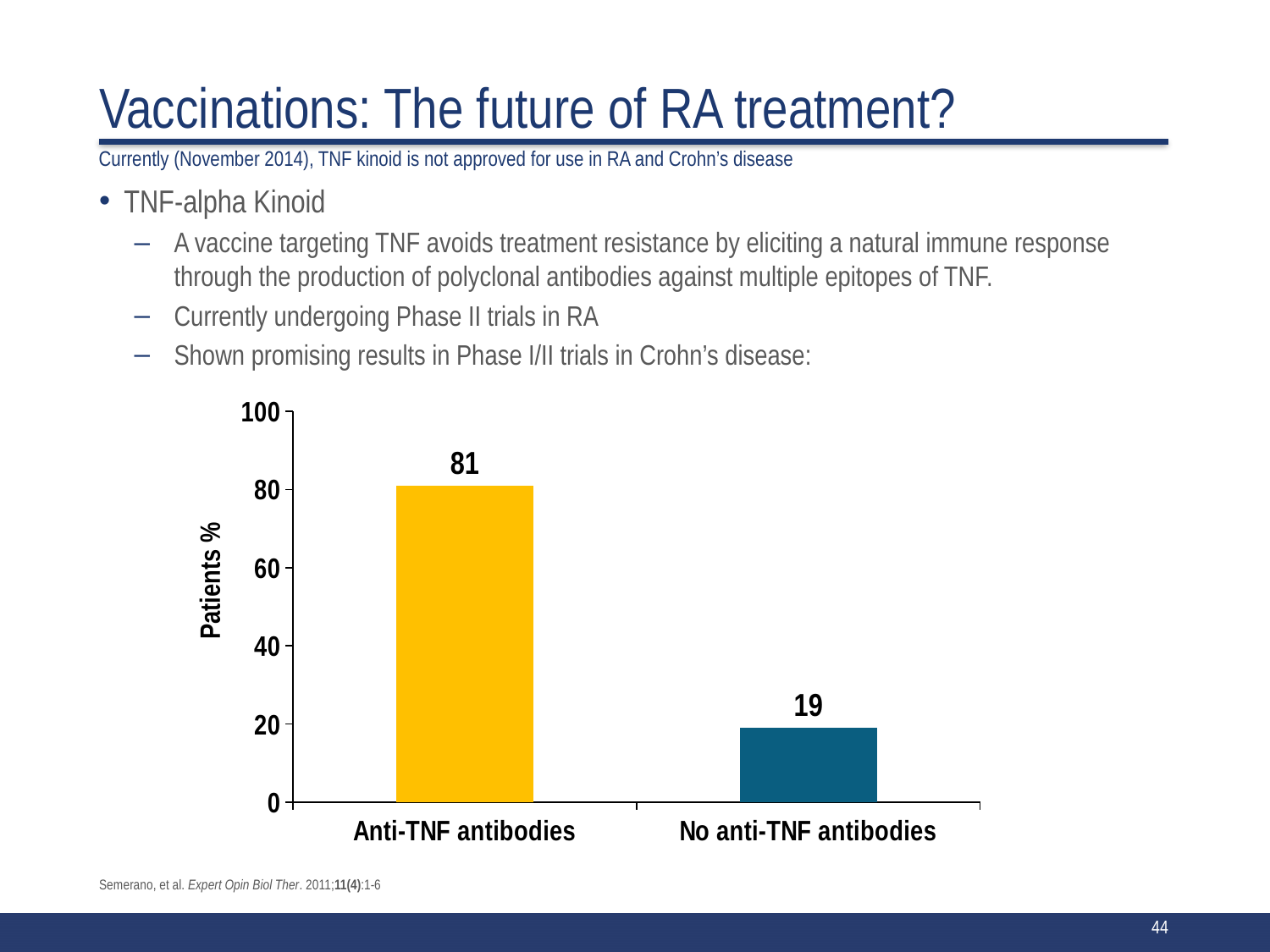
What is the label of the y axis? Patients % Is the value for Anti-TNF antibodies greater or less than 80? greater Which is larger, the value for Anti-TNF antibodies or for No anti-TNF antibodies? Anti-TNF antibodies What is the difference between the values for Anti-TNF antibodies and No anti-TNF antibodies? 62 Which category has the highest value? Anti-TNF antibodies What is the value for Anti-TNF antibodies? 81 What kind of chart is shown on the slide? bar chart How many categories are shown on the x axis? 2 Which category has the lowest value? No anti-TNF antibodies What is the value for No anti-TNF antibodies? 19 What colour is the bar for Anti-TNF antibodies? yellow Is the value for No anti-TNF antibodies greater or less than 20? less